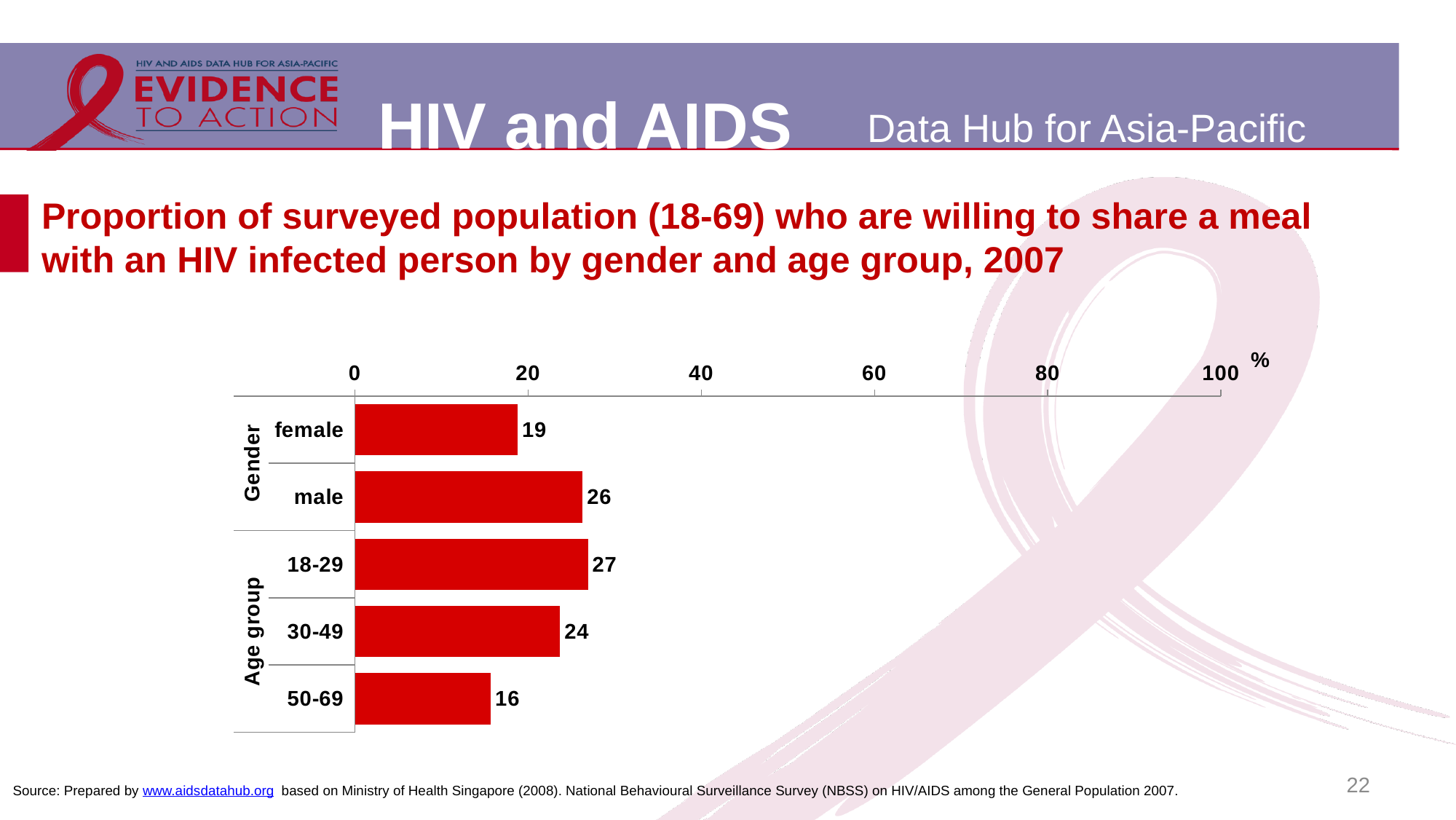
What is the value for the 18-29 age group? 27 What is the value for male? 26 Which category has the highest value? 18-29 Which category has the lowest value? 50-69 What is the value for the 50-69 age group? 16 What kind of chart is shown on the slide? bar chart What is the difference between the values for male and female? 7 How many bars are shown in the chart? 5 What is the maximum value shown on the horizontal axis? 100 Which is larger, the value for 30-49 or the value for 50-69? 30-49 What is the value for female? 19 Is the value for 18-29 greater or less than 40? less